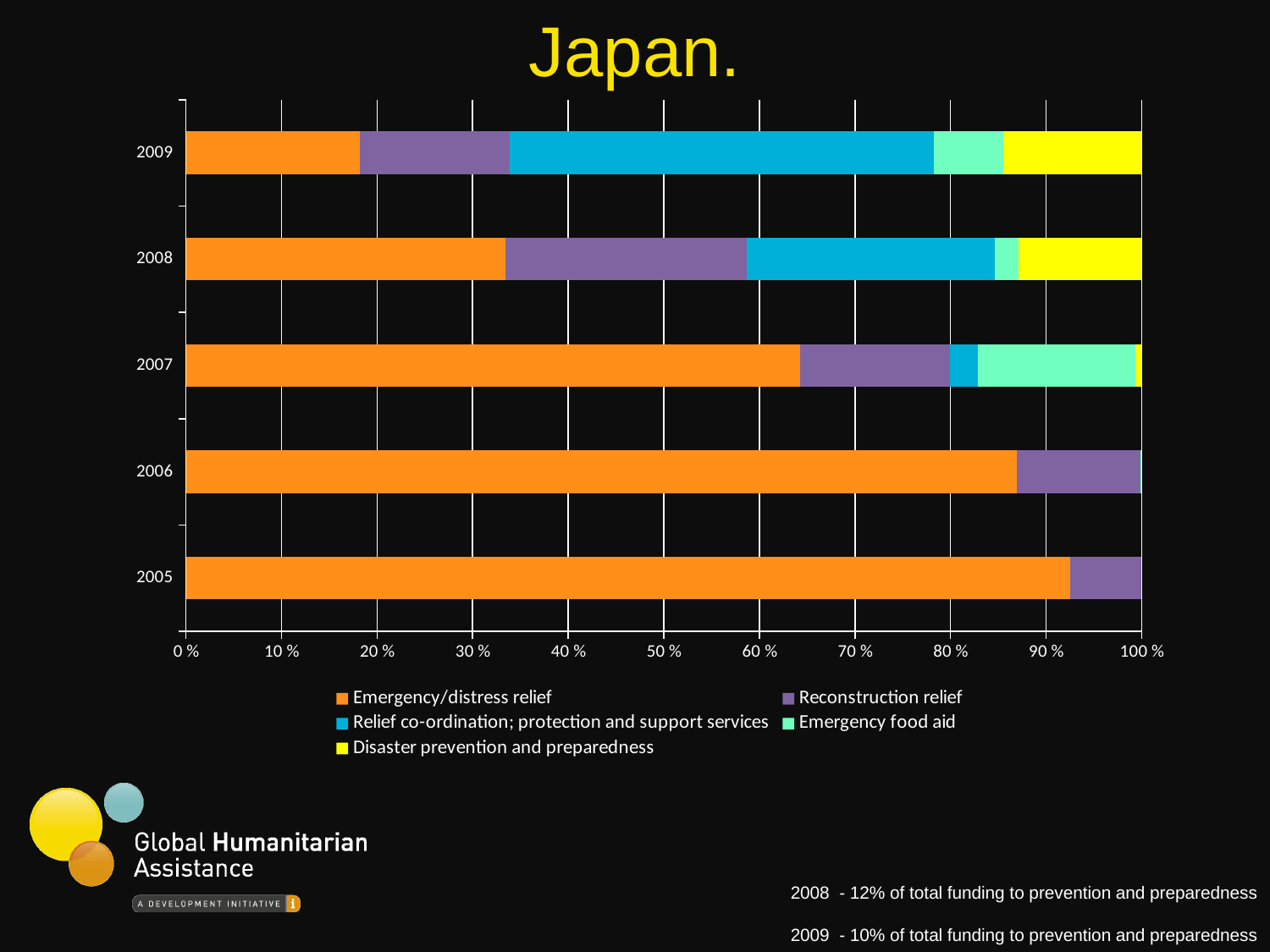
Is the Emergency/distress relief share for 2006 greater or less than 80%? greater How many series does the legend list? 5 Which colour represents Disaster prevention and preparedness in the legend? Yellow What is the title of the chart? Japan. Which year has the largest share for Emergency/distress relief? 2005 Which year has the smallest share for Emergency/distress relief? 2009 What kind of chart is shown on the slide? Stacked bar chart According to the note on the slide, what share of total funding went to prevention and preparedness in 2009? 10% According to the note on the slide, what share of total funding went to prevention and preparedness in 2008? 12% Which year has the larger Emergency/distress relief share, 2008 or 2009? 2008 Is the Emergency/distress relief share for 2009 greater or less than 20%? less How many years are shown on the chart? 5